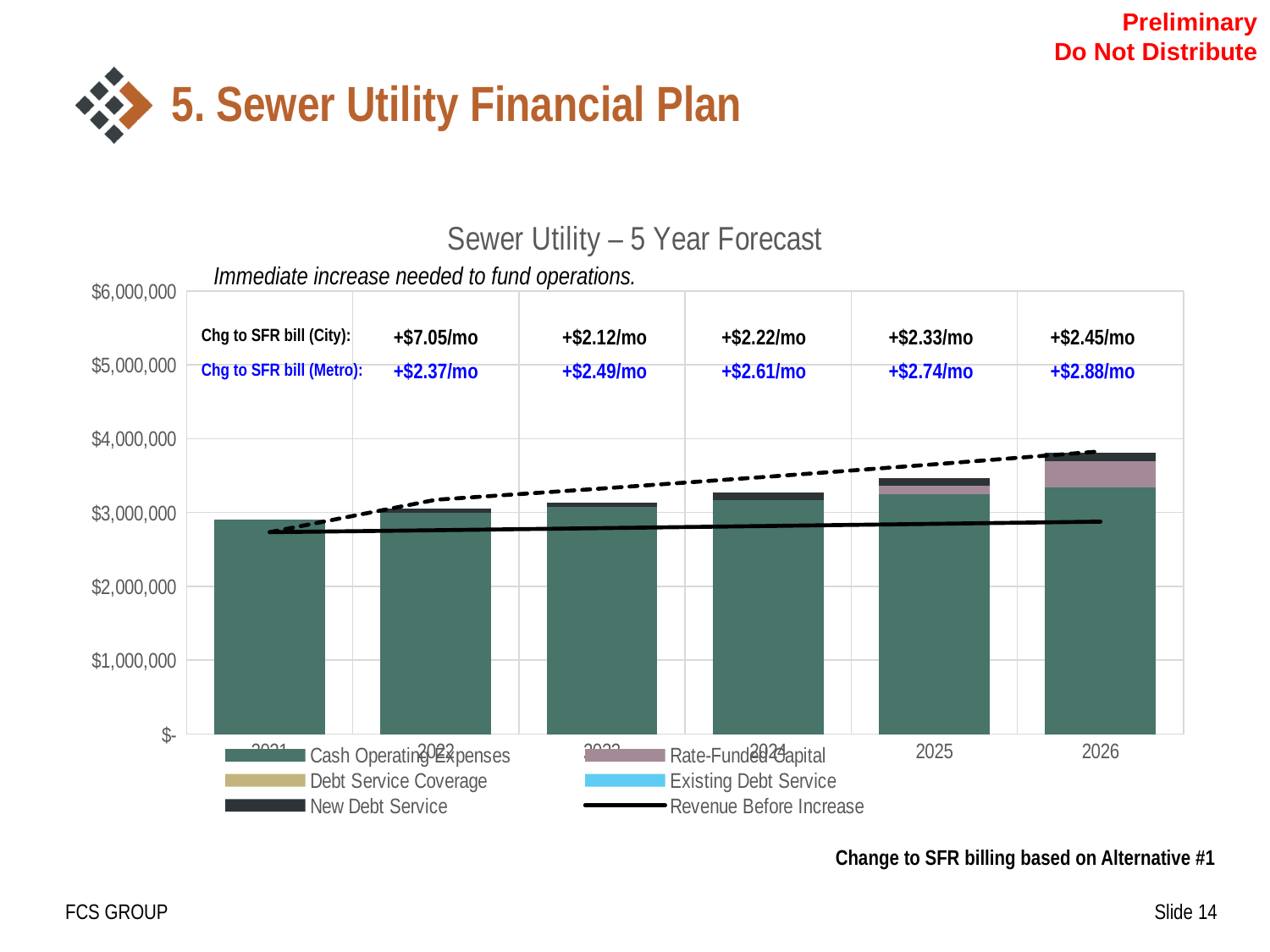
How many years are shown along the x axis of the chart? 6 What kind of chart is shown on the slide? Stacked bar chart with a line Is the total height of the 2021 bar greater or less than $3,000,000? less In which year is the change to the SFR bill (City) the largest? 2022 Do the total bar heights rise or fall from 2021 to 2026? rise What is the change to the SFR bill (City) shown for 2022? +$7.05/mo What is the title of the chart? Sewer Utility – 5 Year Forecast For 2026, which is larger: the change to the SFR bill for City or for Metro? Metro What is the change to the SFR bill (Metro) shown for 2026? +$2.88/mo What is the difference between the City SFR bill change in 2022 and in 2023? $4.93/mo How many series does the chart legend list? 6 What is the change to the SFR bill (City) shown for 2024? +$2.22/mo